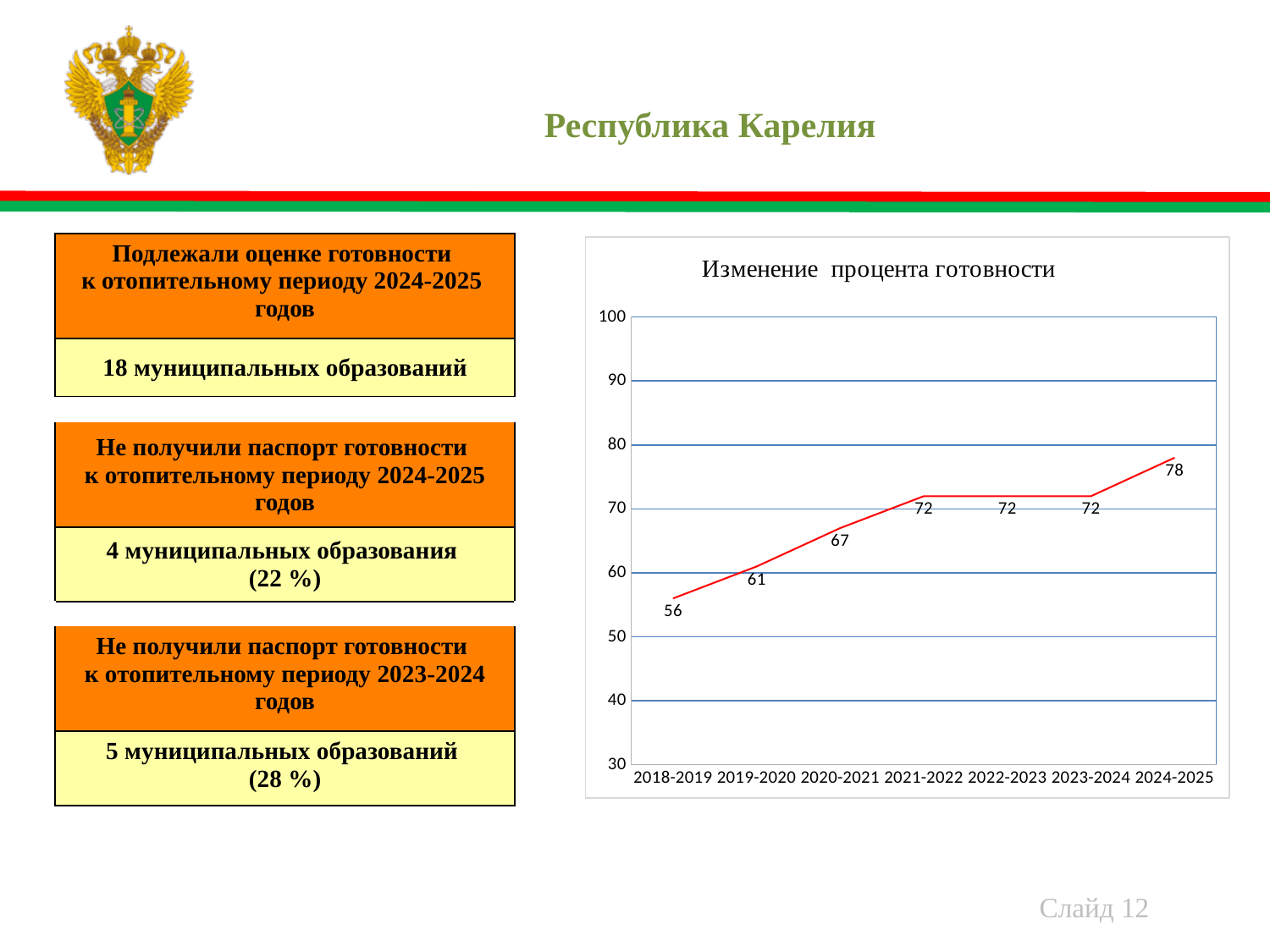
Which is larger, the value for 2021-2022 or the value for 2019-2020? 2021-2022 What is the value for 2024-2025 in the chart? 78 What is the difference between the values for 2020-2021 and 2019-2020? 6 What is the difference between the values for 2024-2025 and 2018-2019? 22 Do the values in the chart generally rise or fall from 2018-2019 to 2024-2025? rise What is the value for 2018-2019 in the chart 'Изменение процента готовности'? 56 What kind of chart is shown on the slide? line chart What is the value for 2020-2021 in the chart? 67 Which period has the lowest value in the chart? 2018-2019 Which period has the highest value in the chart? 2024-2025 Is the value for 2024-2025 greater or less than 80? less How many periods are shown on the x axis of the chart? 7